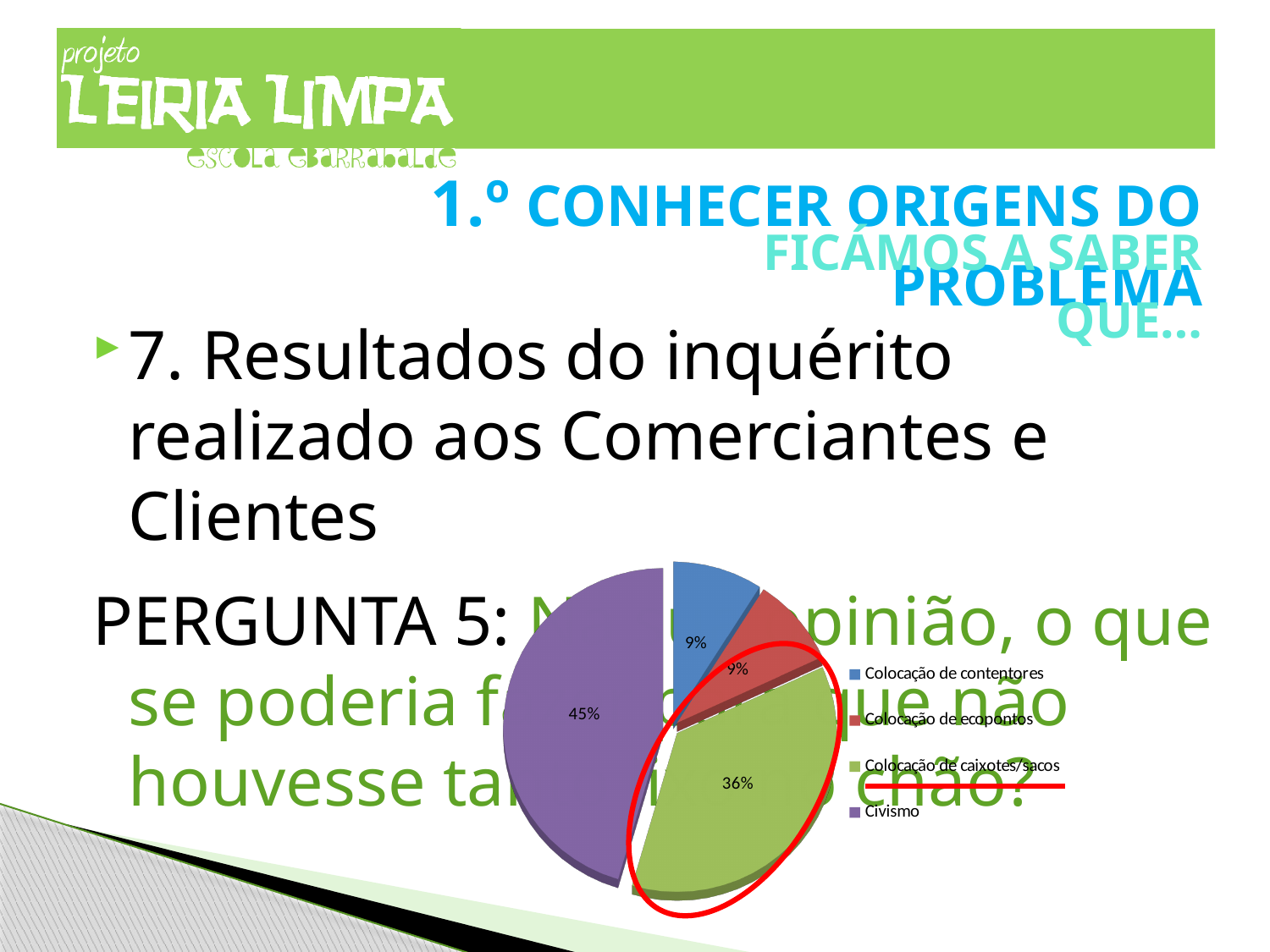
What percentage of the pie does the Colocação de contentores slice represent? 9% What is the difference in percentage points between the Civismo slice and the Colocação de caixotes/sacos slice? 9 What kind of chart is shown on the slide? pie chart What percentage of the pie does the Colocação de ecopontos slice represent? 9% Which colour is used for the Civismo slice in the pie chart? purple What percentage of the pie does the Civismo slice represent? 45% How many slices does the pie chart have? 4 Which legend entry is shown in green in the pie chart? Colocação de caixotes/sacos Which category has the largest slice of the pie chart? Civismo How many entries does the legend of the pie chart list? 4 Which slice is larger: Civismo or Colocação de caixotes/sacos? Civismo